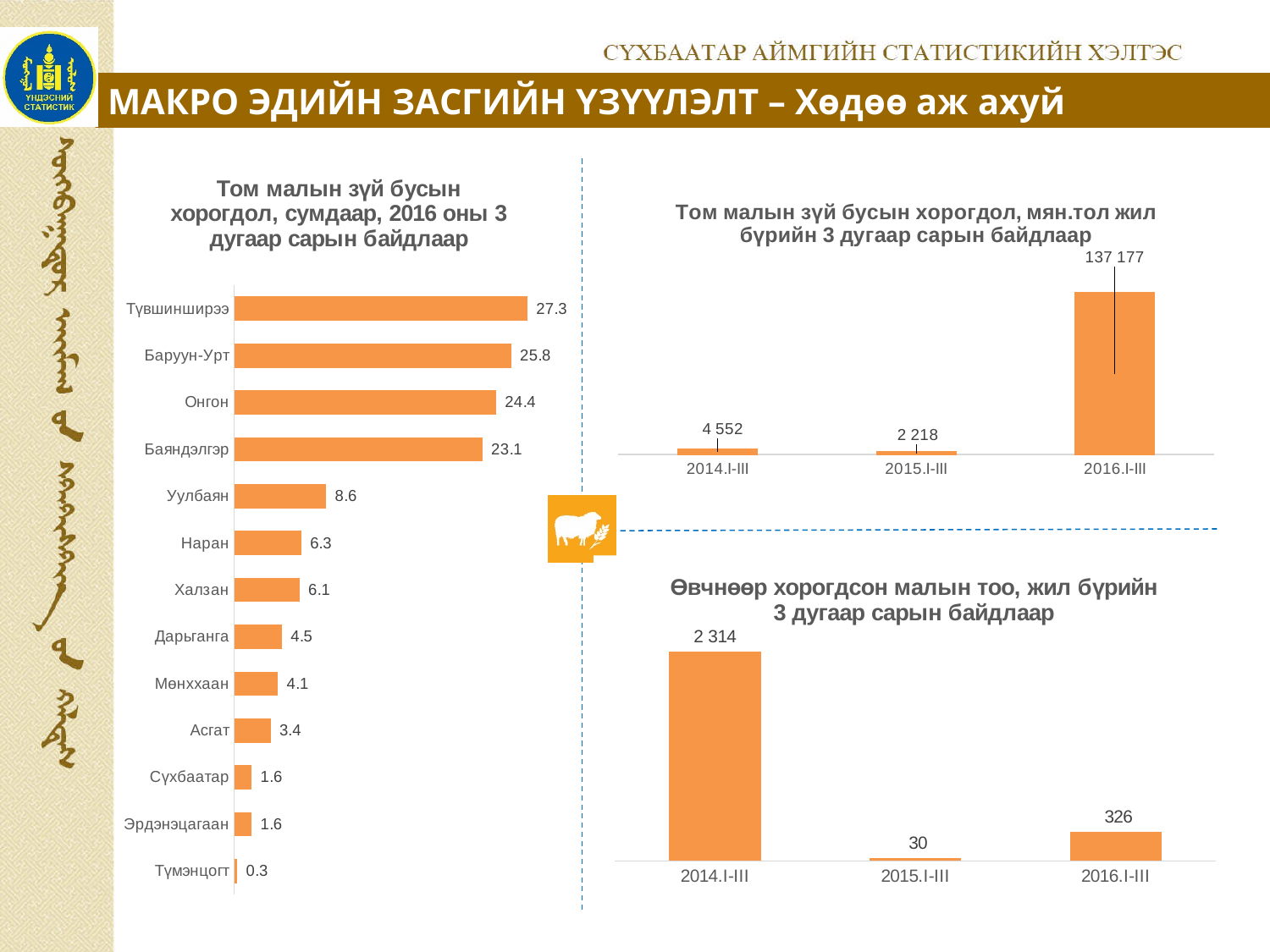
In the left chart (Том малын зүй бусын хорогдол, сумдаар), which is larger, Уулбаян or Наран? Уулбаян In the top right chart (Том малын зүй бусын хорогдол, мян.тол), what is the difference between 2014.I-III and 2015.I-III? 2 334 In the bottom right chart (Өвчнөөр хорогдсон малын тоо), what is the value for 2014.I-III? 2 314 In the left chart (Том малын зүй бусын хорогдол, сумдаар), what is the value for Түвшинширээ? 27.3 In the bottom right chart (Өвчнөөр хорогдсон малын тоо), which is larger, 2015.I-III or 2016.I-III? 2016.I-III In the left chart (Том малын зүй бусын хорогдол, сумдаар), what is the difference between Баруун-Урт and Онгон? 1.4 In the top right chart (Том малын зүй бусын хорогдол, мян.тол), what is the value for 2016.I-III? 137 177 In the left chart (Том малын зүй бусын хорогдол, сумдаар), which soum has the lowest value? Түмэнцогт In the left chart (Том малын зүй бусын хорогдол, сумдаар), how many soums are shown? 13 In the left chart (Том малын зүй бусын хорогдол, сумдаар), which soum has the highest value? Түвшинширээ In the top right chart (Том малын зүй бусын хорогдол, мян.тол), which year has the lowest value? 2015.I-III What type of chart is the left chart (Том малын зүй бусын хорогдол, сумдаар)? Bar chart